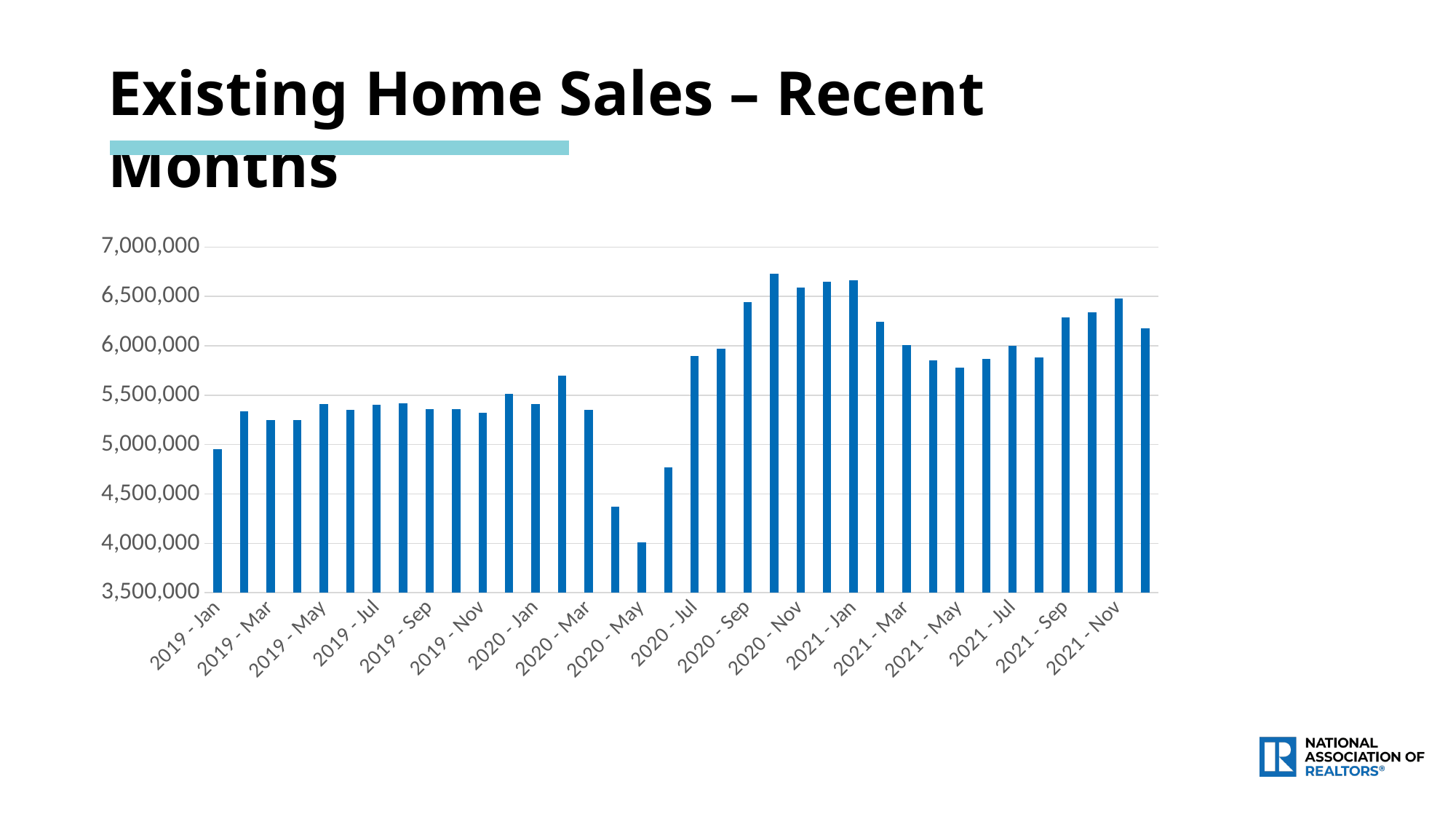
Is the value for 2020 - May greater or less than 4,500,000? less Which labeled month has the lowest existing home sales value? 2020 - May Which is larger, the value for 2021 - Sep or the value for 2021 - Nov? 2021 - Nov Is the value for 2021 - Jan greater or less than 6,500,000? greater What is the title of the slide? Existing Home Sales – Recent Months Do the values rise or fall from 2020 - May to 2020 - Sep? Rise Is the value for 2021 - May greater or less than 6,000,000? less Which is larger, the value for 2019 - Jan or the value for 2021 - Jan? 2021 - Jan How many bars are plotted in the chart? 36 What kind of chart is shown on the slide? Bar chart What is the highest value shown on the vertical axis? 7,000,000